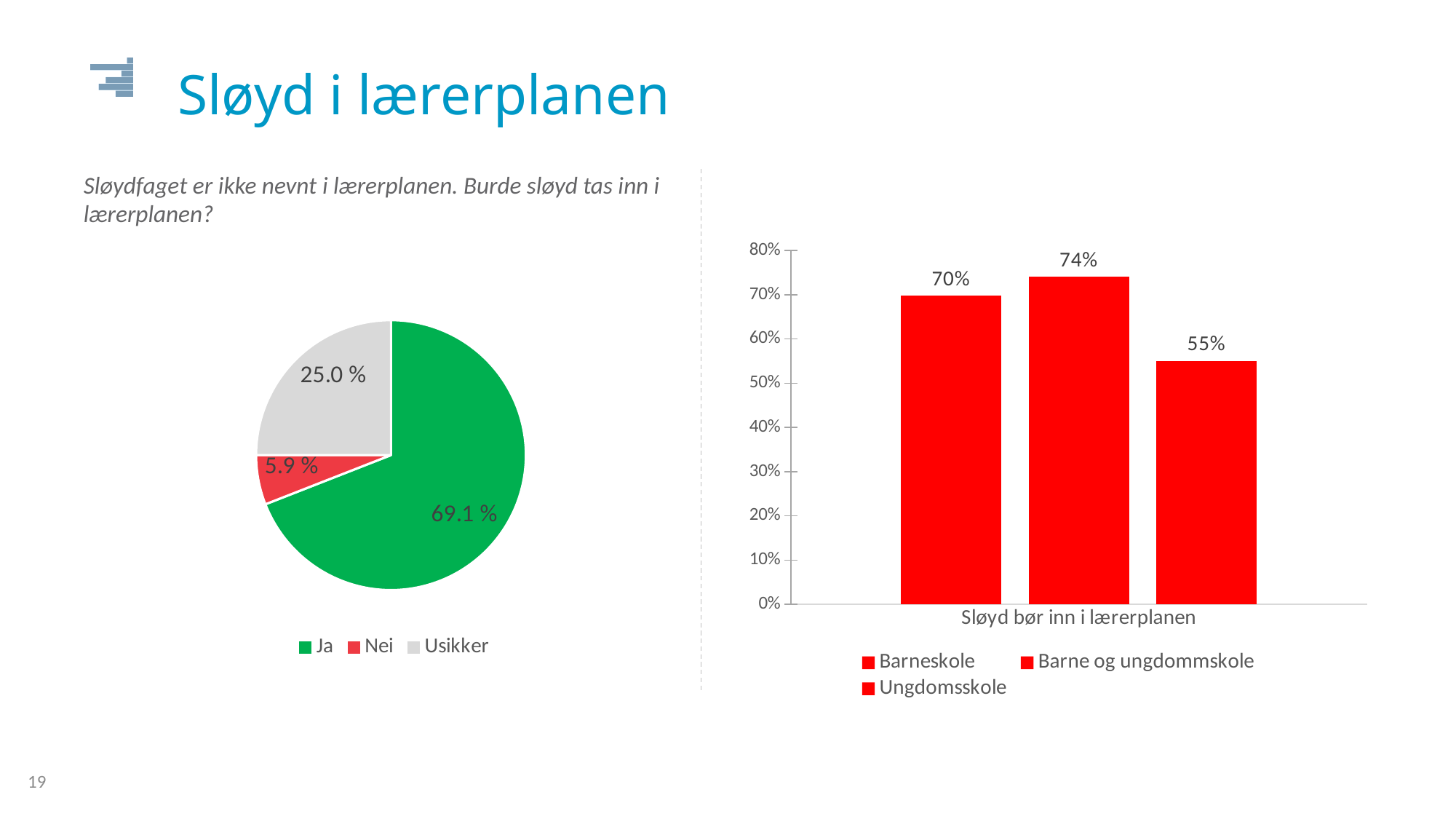
In the bar chart on the right, which group has the highest value? Barne og ungdommskole In the bar chart on the right, what is the value for Ungdomsskole? 55% In the bar chart on the right, what is the difference between the values for Barne og ungdommskole and Ungdomsskole? 19% In the pie chart on the left, which answer has the largest slice? Ja In the pie chart on the left, which answer has the smallest slice? Nei In the pie chart on the left, what share of respondents answered "Ja"? 69.1 % What kind of chart is shown on the right side of the slide? Bar chart In the pie chart on the left, what share of respondents answered "Nei"? 5.9 % In the bar chart on the right, how many series does the legend list? 3 In the bar chart on the right, what is the value for Barneskole? 70% In the pie chart on the left, how many slices are there? 3 In the pie chart on the left, what share of respondents answered "Usikker"? 25.0 %